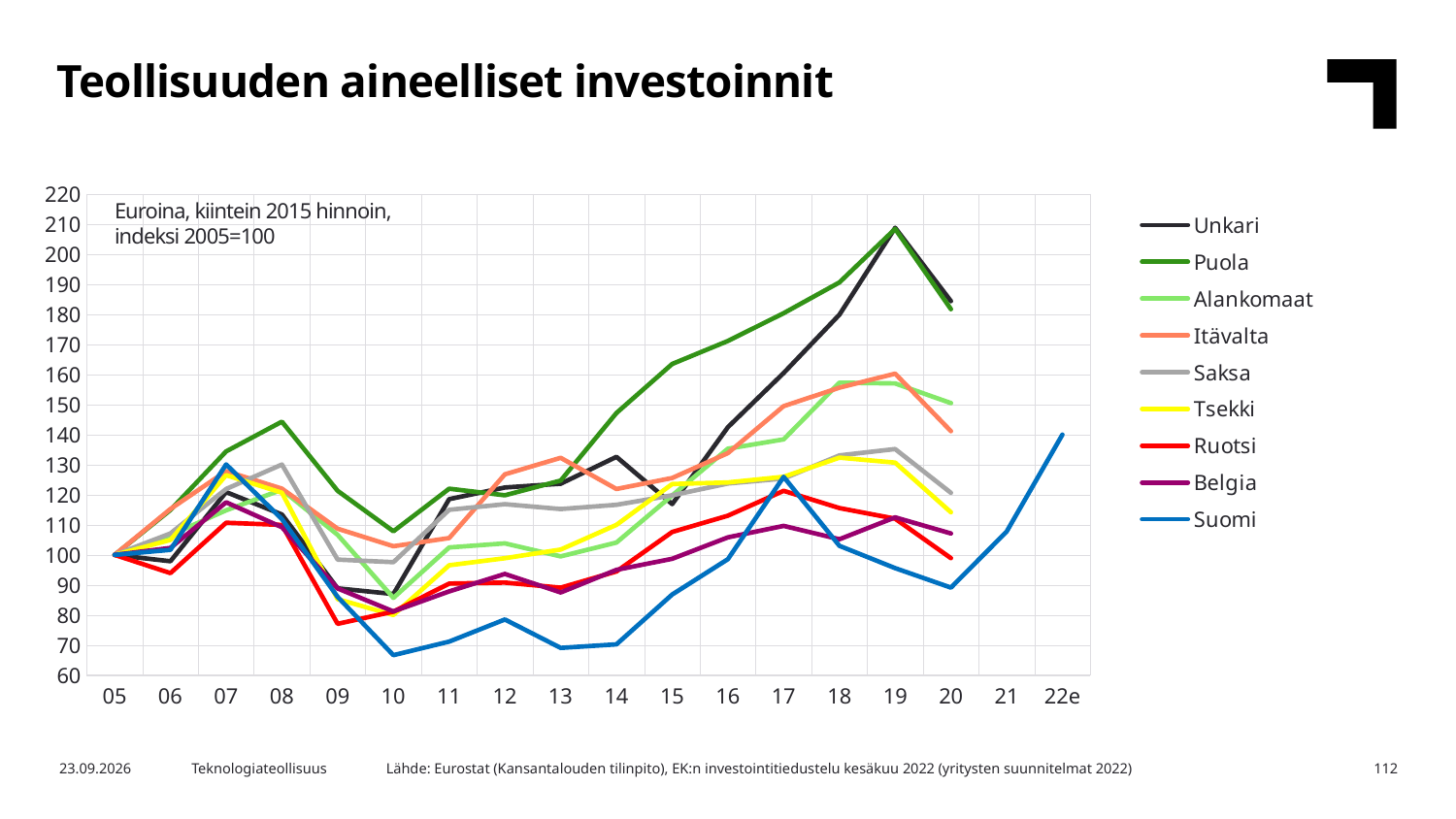
What kind of chart is shown on the slide? line chart Which series has the lowest value in 2013? Suomi How many series does the legend list? 9 Is the value for Puola in 2019 greater or less than 200? greater Is the value for Suomi in 22e greater or less than 130? greater How many year labels are shown on the x axis? 18 Which series has the lowest value in 2010? Suomi Is the value for Suomi in 2010 greater or less than 70? less In 2020, which is larger, the value for Puola or the value for Ruotsi? Puola Does the Suomi line rise or fall from 2020 to 22e? rise Which series is the only one plotted through 21 and 22e? Suomi Which series has the highest value in 2016? Puola